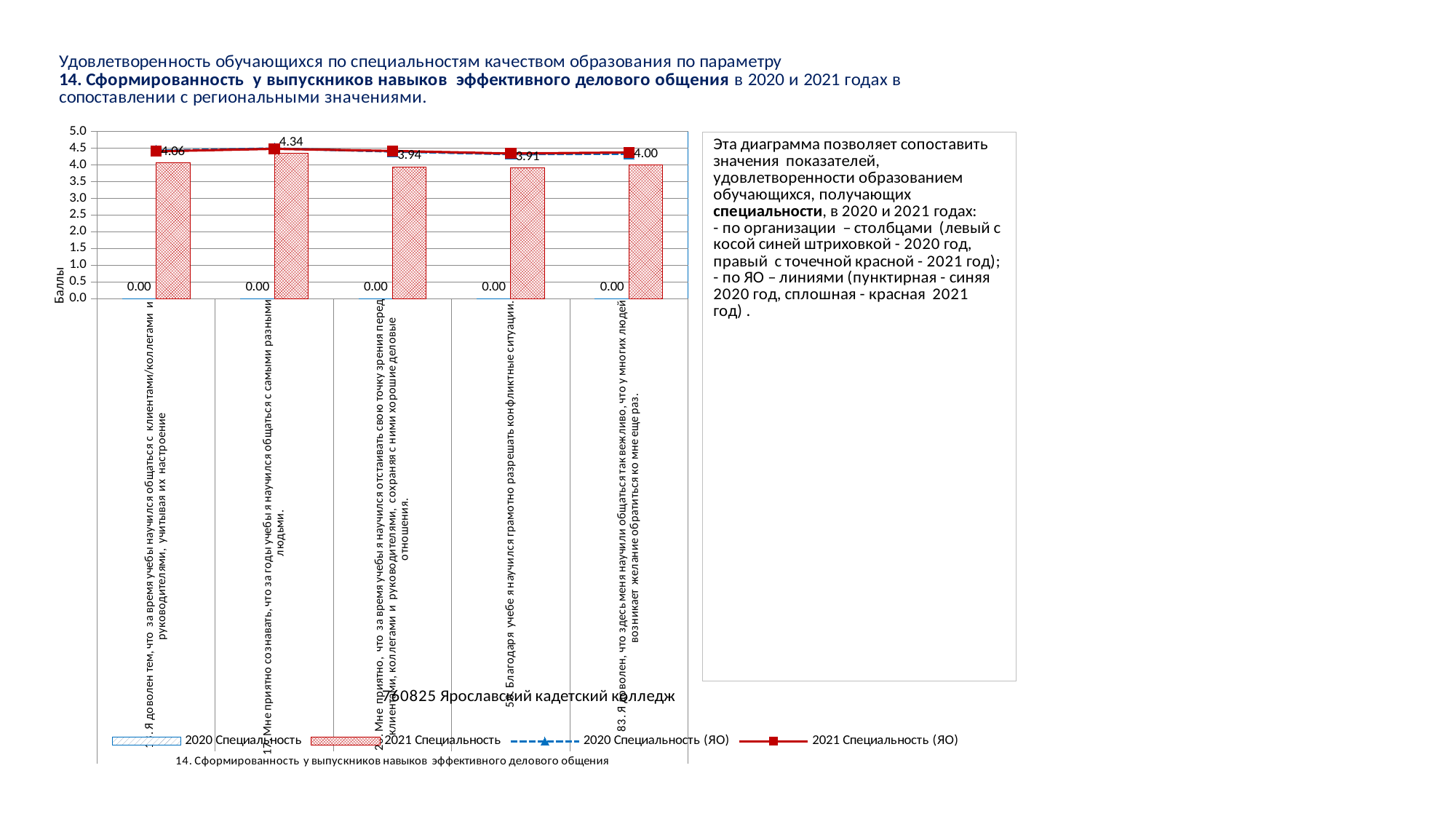
What is the 2020 Специальность value for the category "Я доволен, что здесь меня научили общаться так вежливо, что у многих людей возникает желание обратиться ко мне еще раз"? 0.00 Which is larger for 2021 Специальность: the first category ("Я доволен тем, что за время учебы научился общаться с клиентами/коллегами...") or the last category ("Я доволен, что здесь меня научили общаться так вежливо...")? The first category (4.06) Which category has the highest 2021 Специальность value? Мне приятно сознавать, что за годы учебы я научился общаться с самыми разными людьми How many series does the chart legend list? 4 What is the difference between the highest and lowest 2021 Специальность values? 0.43 Is the 2021 Специальность (ЯО) line value for the category "Благодаря учебе я научился грамотно разрешать конфликтные ситуации" greater or less than 4.0? greater What is the 2021 Специальность value for the category "Благодаря учебе я научился грамотно разрешать конфликтные ситуации"? 3.91 What is the 2021 Специальность value for the category "Мне приятно сознавать, что за годы учебы я научился общаться с самыми разными людьми"? 4.34 How many categories are shown on the x axis of the chart? 5 What is the label of the vertical axis of the chart? Баллы What kind of chart is shown on the slide? A bar chart combined with line series Which category has the lowest 2021 Специальность value? Благодаря учебе я научился грамотно разрешать конфликтные ситуации